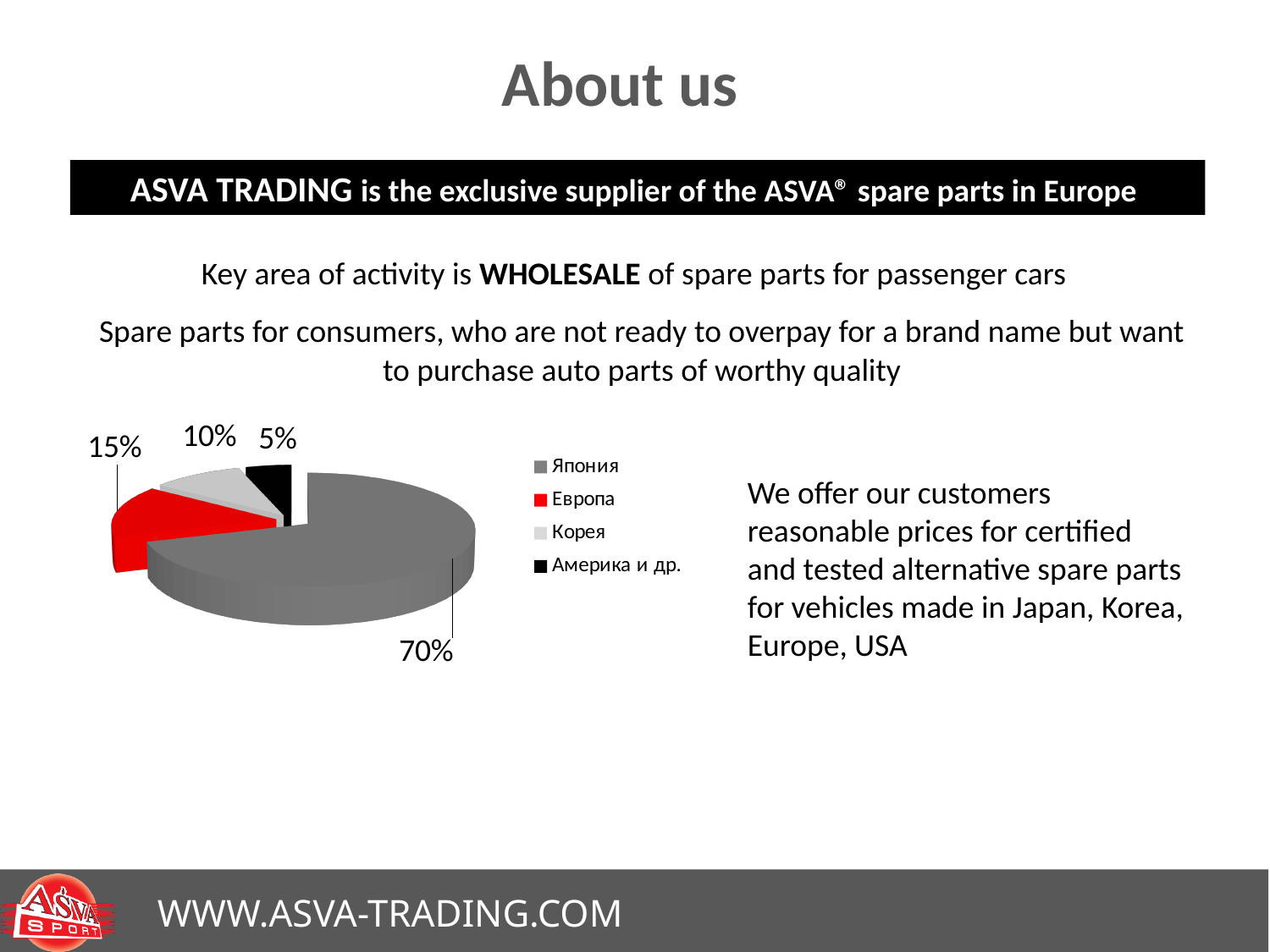
What kind of chart is shown on the slide? pie chart Which category has the largest slice of the pie? Япония Which is larger, the share of Европа or the share of Корея? Европа What colour is the slice for Европа? red What is the difference between the shares of Япония and Европа? 55% What share of the pie does Европа have? 15% What is the combined share of Корея and Америка и др.? 15% What share of the pie does Америка и др. have? 5% What share of the pie does Корея have? 10% What share of the pie does Япония have? 70% How many categories does the pie chart have? 4 Which category has the smallest slice of the pie? Америка и др.